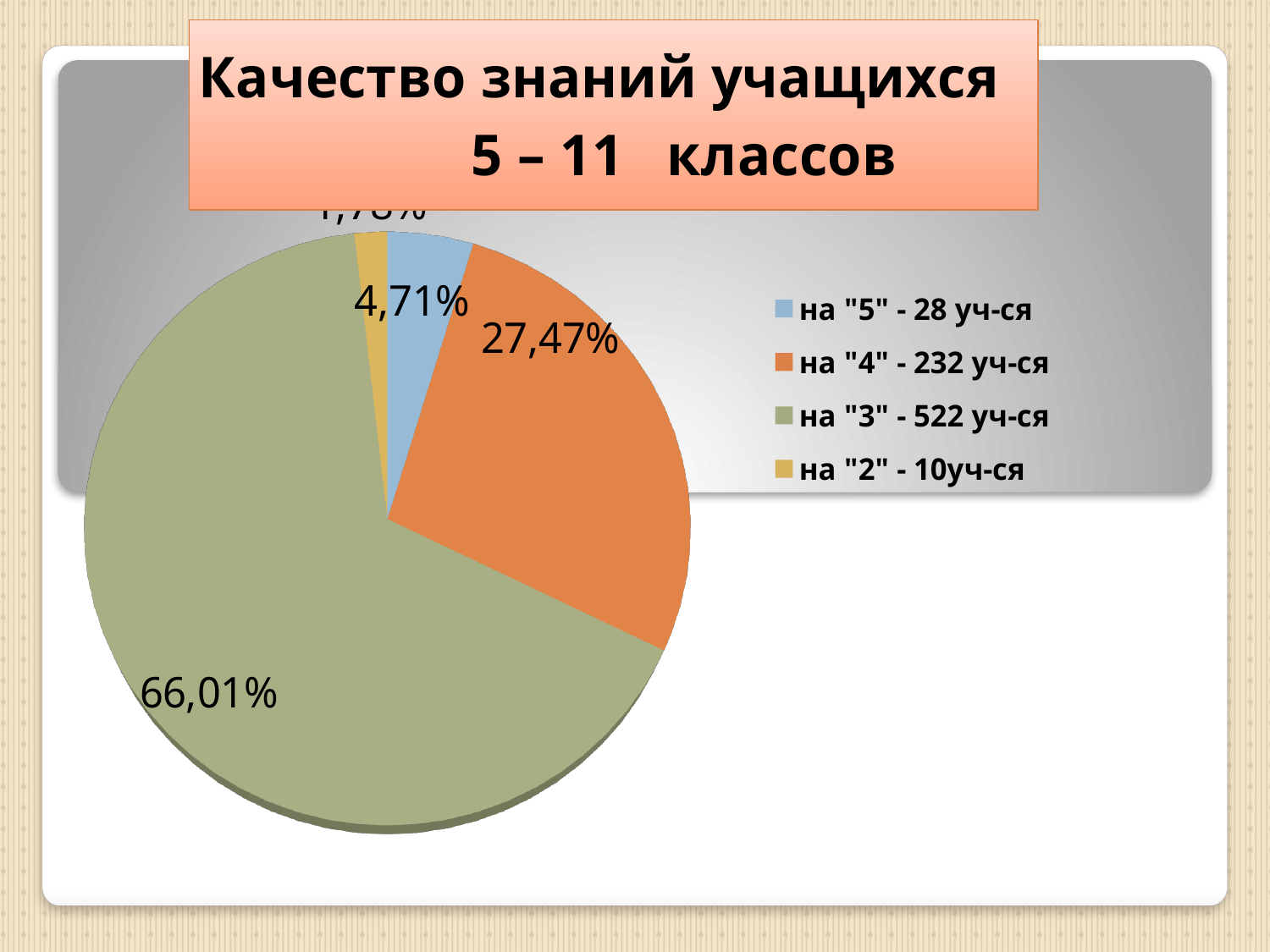
Which category has the smallest slice of the pie? на "2" - 10уч-ся Which category has the largest slice of the pie? на "3" - 522 уч-ся What percentage of the pie is the slice for на "4" - 232 уч-ся? 27,47% What is the difference in percentage points between the slice for на "3" - 522 уч-ся and the slice for на "4" - 232 уч-ся? 38,54% How many entries does the legend list? 4 What percentage of the pie is the slice for на "5" - 28 уч-ся? 4,71% What is the title of the chart on the slide? Качество знаний учащихся 5 – 11 классов How many slices does the pie chart have? 4 What kind of chart is shown on the slide? pie chart What percentage of the pie is the slice for на "3" - 522 уч-ся? 66,01% Which slice is larger: на "4" - 232 уч-ся or на "5" - 28 уч-ся? на "4" - 232 уч-ся What is the difference in percentage points between the slice for на "4" - 232 уч-ся and the slice for на "5" - 28 уч-ся? 22,76%